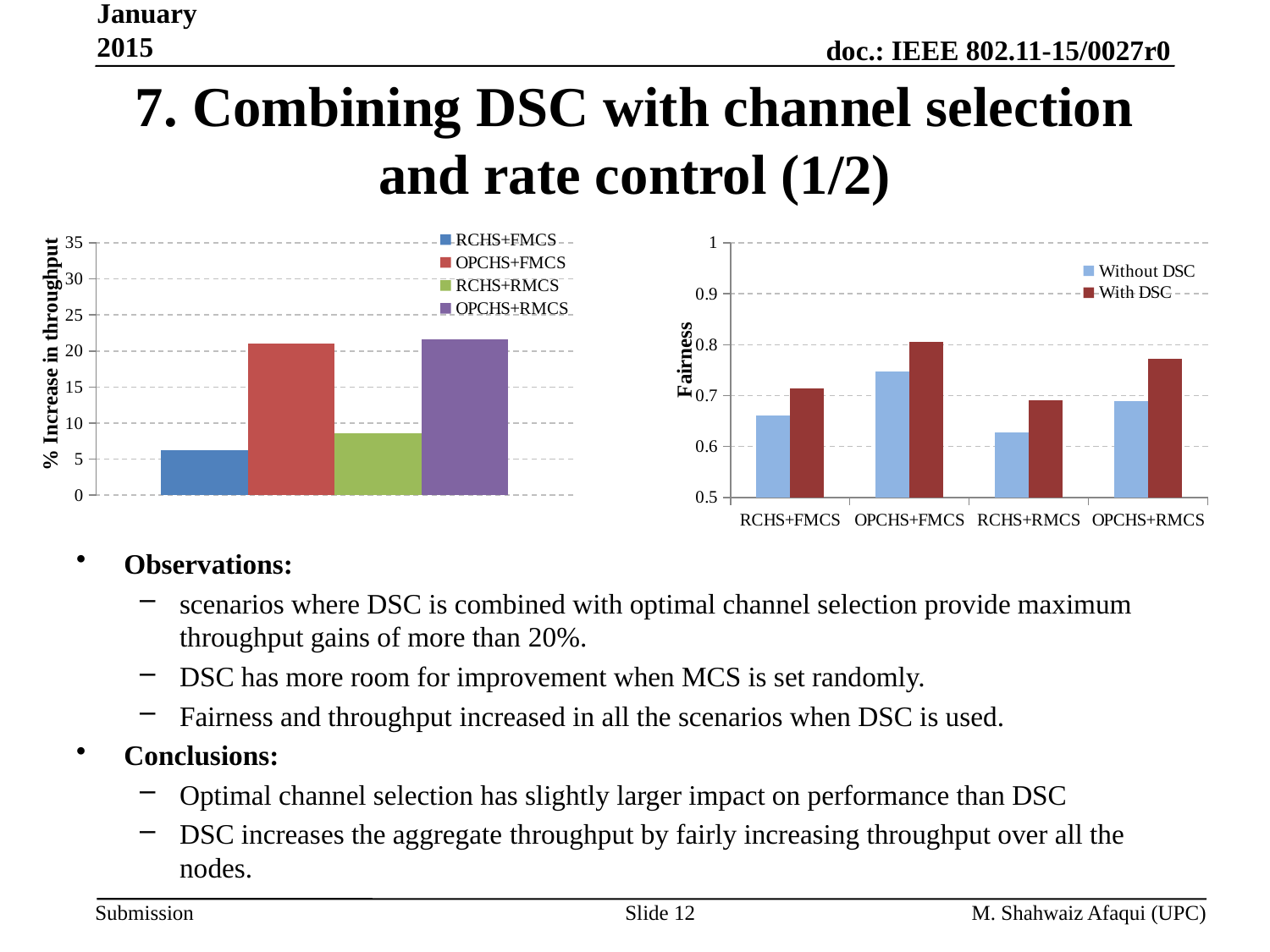
On the right chart (Fairness), which series does the legend list besides 'Without DSC'? With DSC On the left chart (% Increase in throughput), is the value for OPCHS+FMCS greater or less than 20? greater On the left chart (% Increase in throughput), which is larger, the value for RCHS+RMCS or the value for RCHS+FMCS? RCHS+RMCS On the right chart (Fairness), is the Without DSC value for RCHS+RMCS greater or less than 0.7? less On the left chart (% Increase in throughput), how many series does the legend list? 4 On the right chart (Fairness), how many categories are shown on the x axis? 4 On the left chart (% Increase in throughput), which series has the lowest value? RCHS+FMCS On the right chart (Fairness), for RCHS+FMCS, which is larger, the Without DSC value or the With DSC value? With DSC On the left chart (% Increase in throughput), is the value for RCHS+RMCS greater or less than 10? less What kind of chart is the right chart (Fairness)? Bar chart On the right chart (Fairness), which category has the highest With DSC value? OPCHS+FMCS